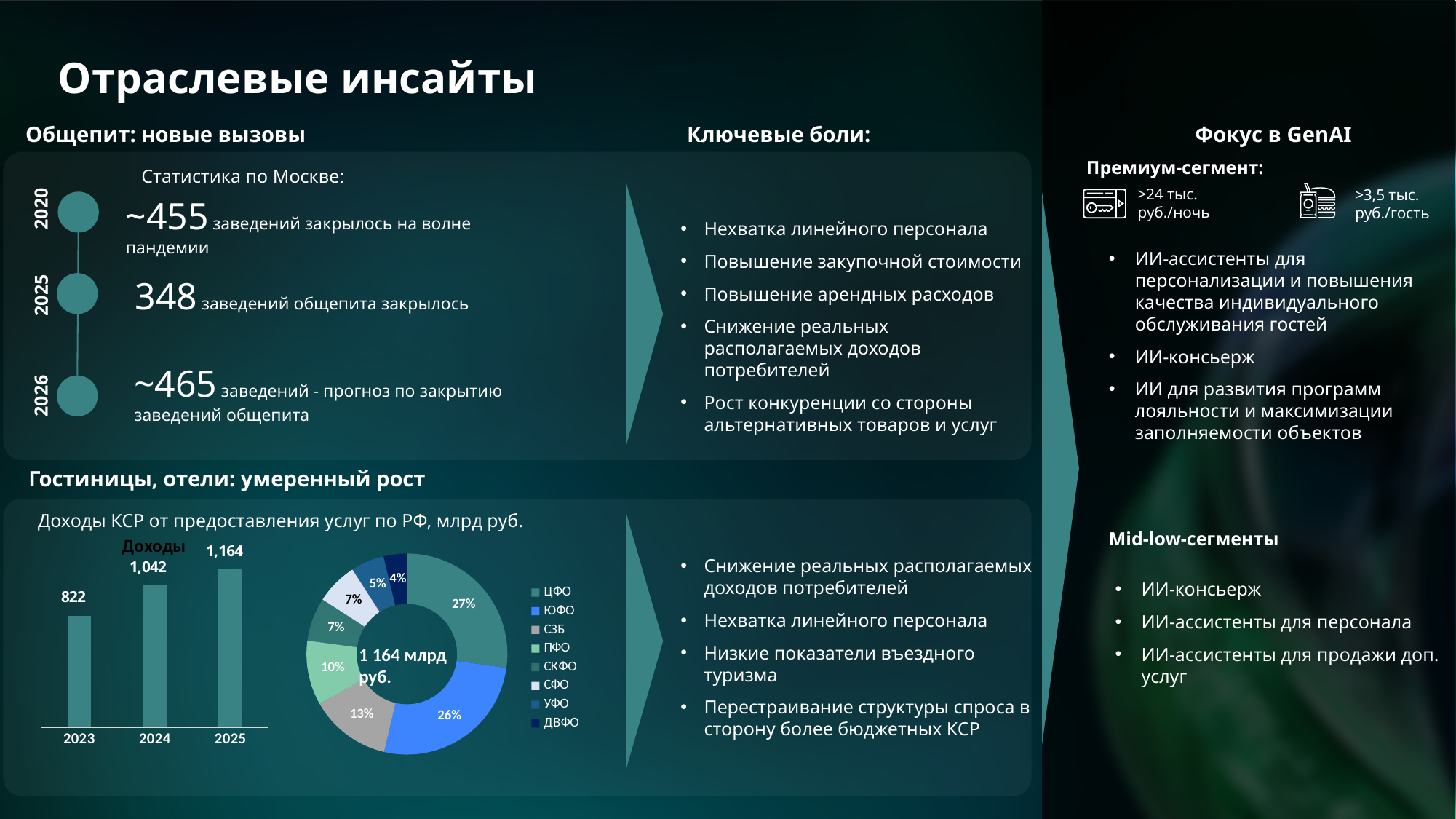
In the bar chart (Доходы), how many years are shown? 3 In the donut chart, what share does ЦФО have? 27% In the bar chart (Доходы), what is the value for 2024? 1,042 What kind of chart is the chart with the years 2023–2025? bar chart In the bar chart (Доходы), do the values rise or fall from 2023 to 2025? rise In the donut chart, which is larger: the share of СЗБ or the share of ПФО? СЗБ In the bar chart (Доходы), what is the difference between the 2025 and 2023 values? 342 In the bar chart (Доходы), which year has the lowest value? 2023 In the donut chart, how many regions does the legend list? 8 In the donut chart, which region has the smallest share? ДВФО In the bar chart (Доходы), what is the value for 2023? 822 In the bar chart (Доходы), which year has the highest value? 2025